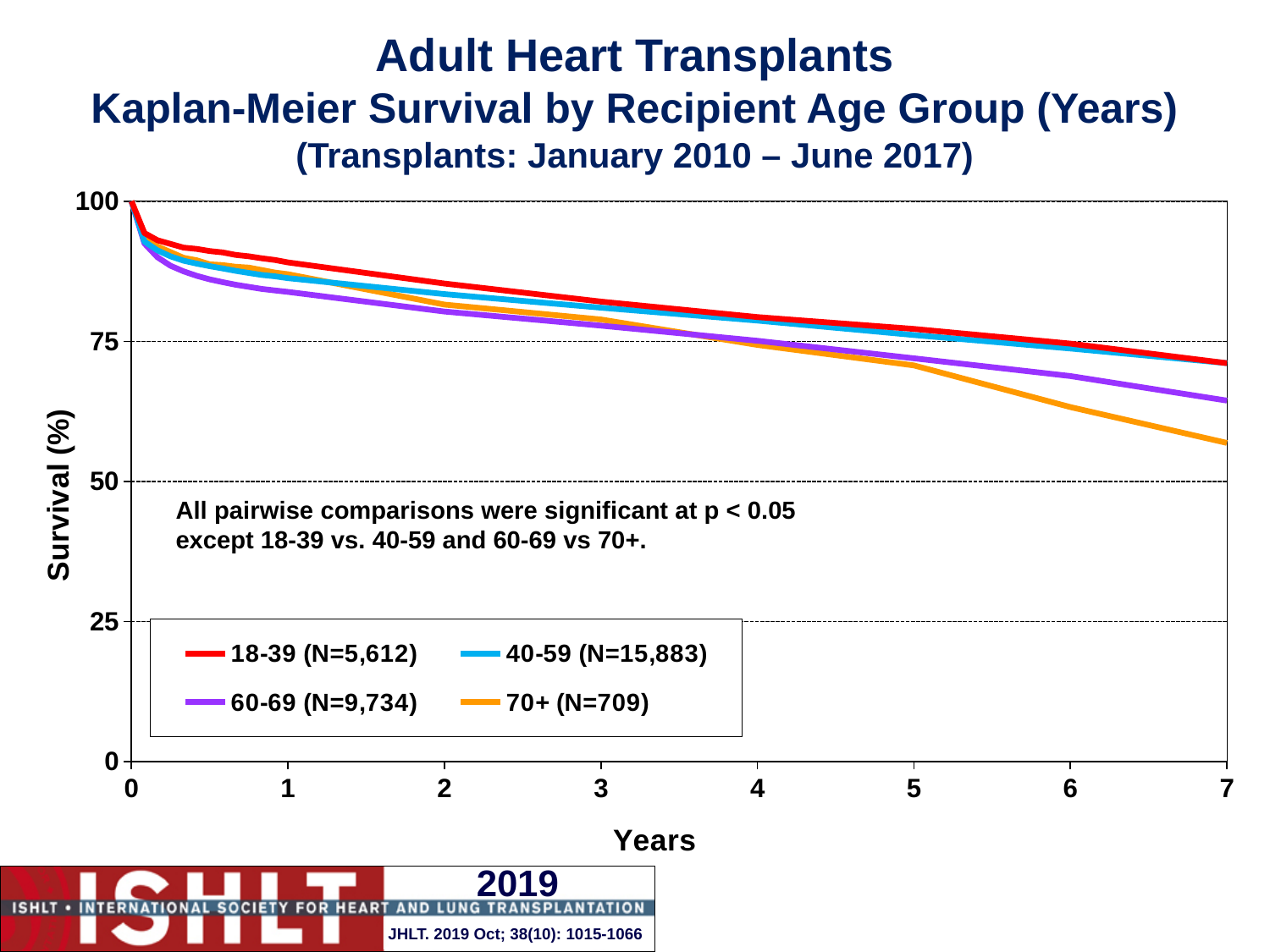
At year 7, which age group has the lowest survival? 70+ What kind of chart is shown on the slide? Line chart Do the survival curves rise or fall as years increase? Fall Which colour represents the 60-69 group? Purple How many series does the legend list? 4 At year 7, is the survival value for the 60-69 group greater or less than 75? less At year 7, which has higher survival: the 18-39 group or the 70+ group? 18-39 At year 1, is the survival value for the 18-39 group greater or less than 75? greater At year 7, is the survival value for the 70+ group greater or less than 50? greater What is the N shown in the legend for the 70+ group? 709 At year 1, which age group has the highest survival? 18-39